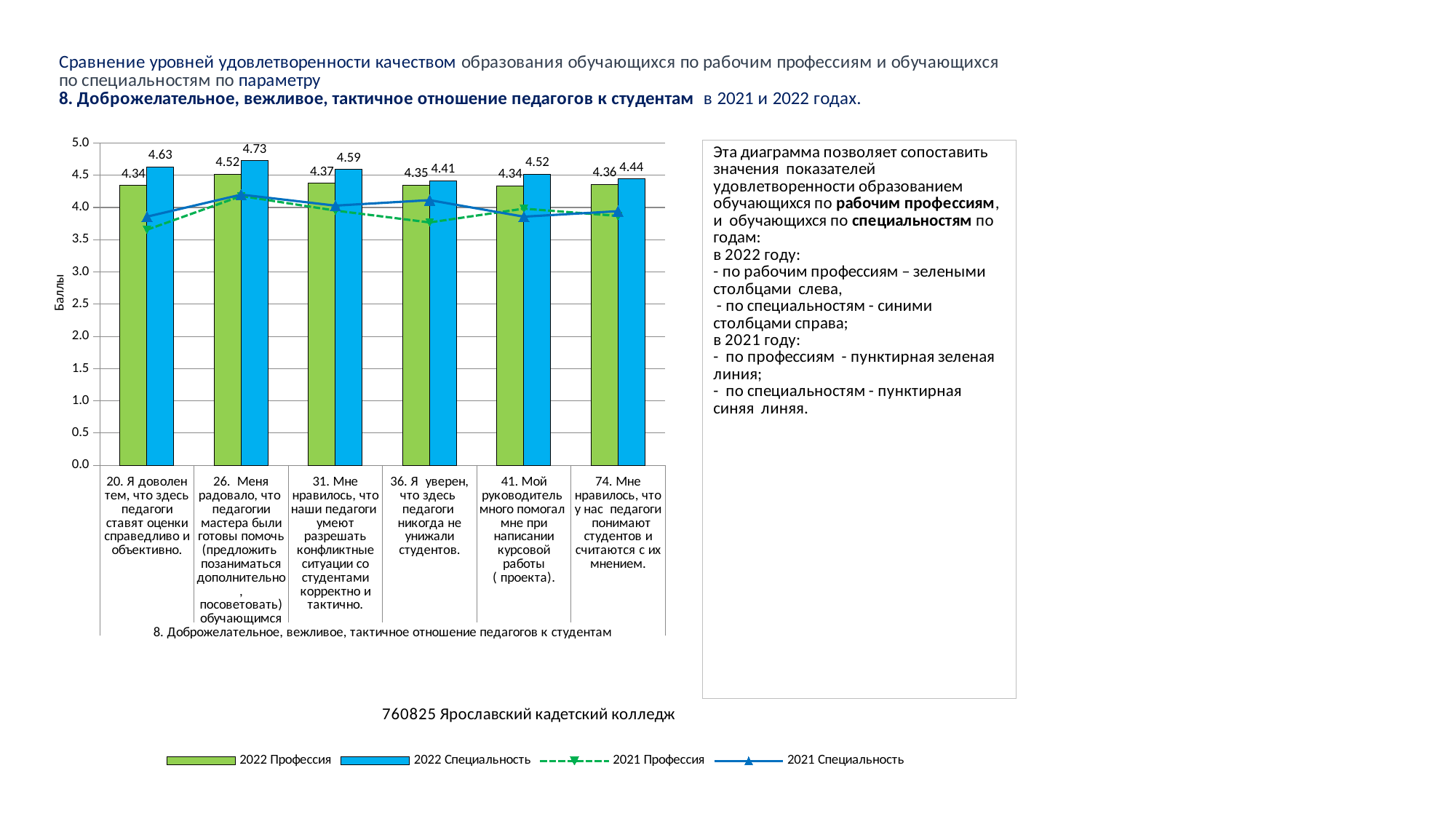
What is the value of the 2022 Профессия bar for item 31 (Мне нравилось, что наши педагоги умеют разрешать конфликтные ситуации)? 4.37 How many series does the chart legend list? 4 What is the difference between the 2022 Специальность and 2022 Профессия bars for item 20 (Я доволен тем, что здесь педагоги ставят оценки справедливо и объективно)? 0.29 For item 41 (Мой руководитель много помогал мне при написании курсовой работы), which 2022 bar is larger: Профессия or Специальность? Специальность What is the label of the vertical axis of the chart? Баллы What kind of chart is shown on the slide? Combined bar and line chart How many items (categories) are shown on the x axis of the chart? 6 What is the value of the 2022 Специальность bar for item 26 (Меня радовало, что педагоги и мастера были готовы помочь)? 4.73 Which item has the highest 2022 Специальность bar? 26. Меня радовало, что педагоги и мастера были готовы помочь Which item has the lowest 2022 Специальность bar? 36. Я уверен, что здесь педагоги никогда не унижали студентов Is the 2021 Профессия line value for item 20 greater or less than 4.0? less What is the value of the 2022 Специальность bar for item 36 (Я уверен, что здесь педагоги никогда не унижали студентов)? 4.41